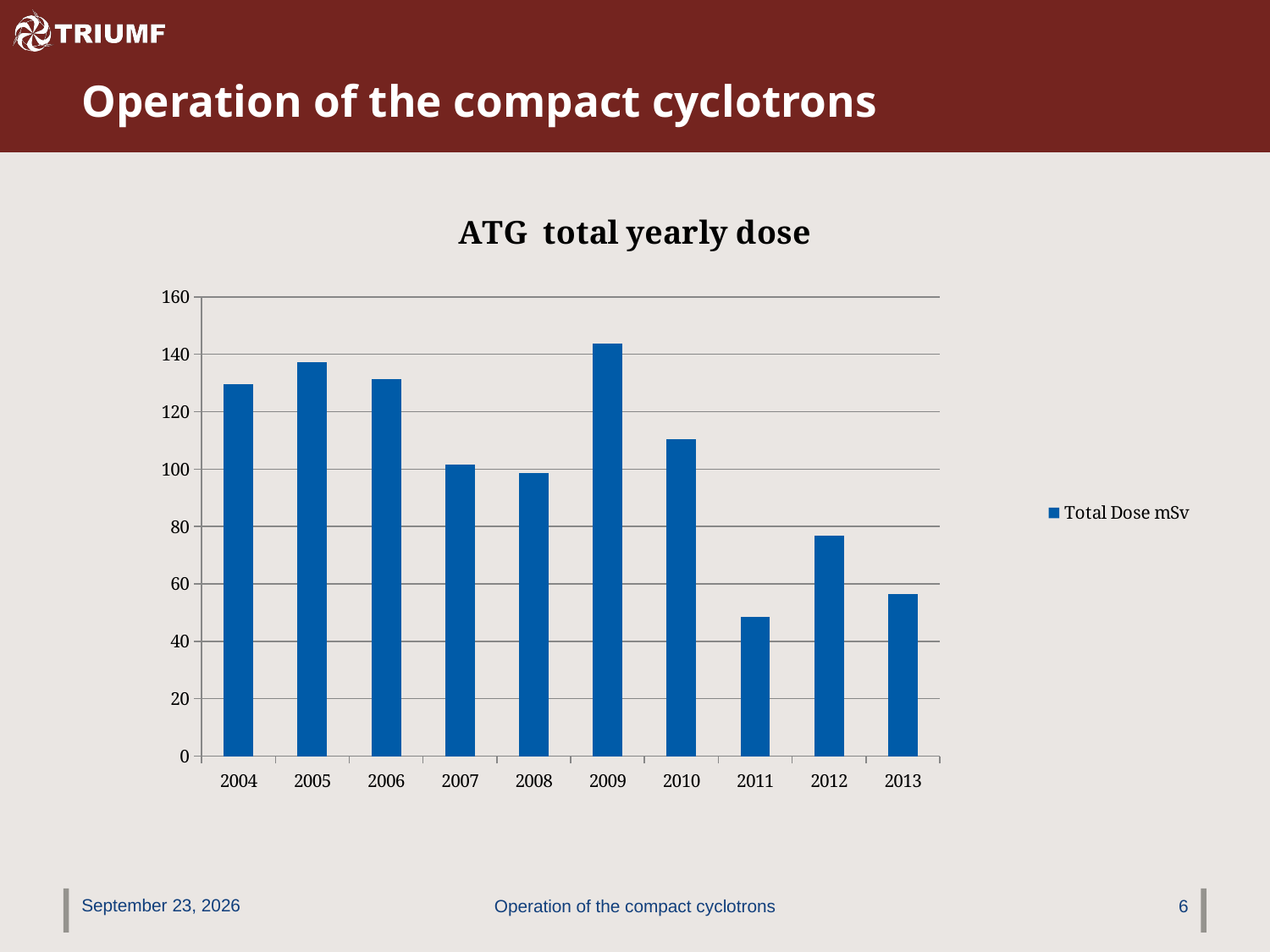
Is the value for 2011 greater or less than 60? less What is the legend entry for the series? Total Dose mSv What is the title of the chart? ATG total yearly dose Which is larger, the value for 2012 or the value for 2013? 2012 Which year has the lowest total dose? 2011 Is the value for 2004 greater or less than 120? greater Overall, do the values rise or fall from 2004 to 2013? fall How many years are shown on the x axis? 10 How many series does the legend list? 1 Is the value for 2010 greater or less than 100? greater What type of chart is shown on the slide? bar chart Which year has the highest total dose? 2009